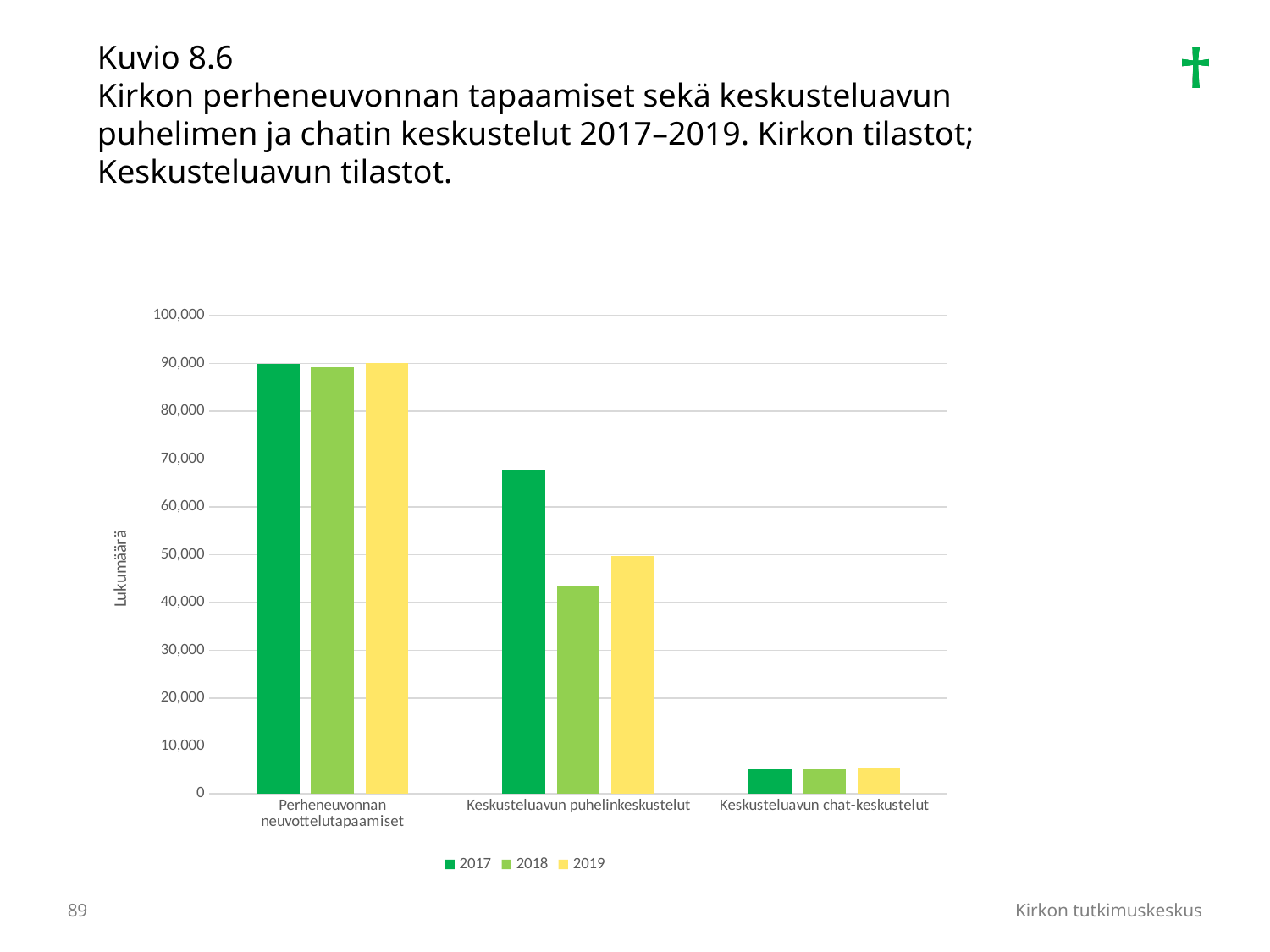
How many series does the legend list? 3 Which category has the lowest value for 2017? Keskusteluavun chat-keskustelut What kind of chart is shown on the slide? bar chart Is the 2017 value for Keskusteluavun puhelinkeskustelut greater or less than 60,000? greater What is the title of the vertical axis? Lukumäärä Is the 2019 value for Perheneuvonnan neuvottelutapaamiset greater or less than 80,000? greater For Keskusteluavun puhelinkeskustelut, which year has the larger value, 2017 or 2018? 2017 For Keskusteluavun puhelinkeskustelut, which year has the larger value, 2018 or 2019? 2019 How many categories are shown on the x axis? 3 Is the 2017 value for Keskusteluavun chat-keskustelut greater or less than 10,000? less Which category has the highest value for 2018? Perheneuvonnan neuvottelutapaamiset